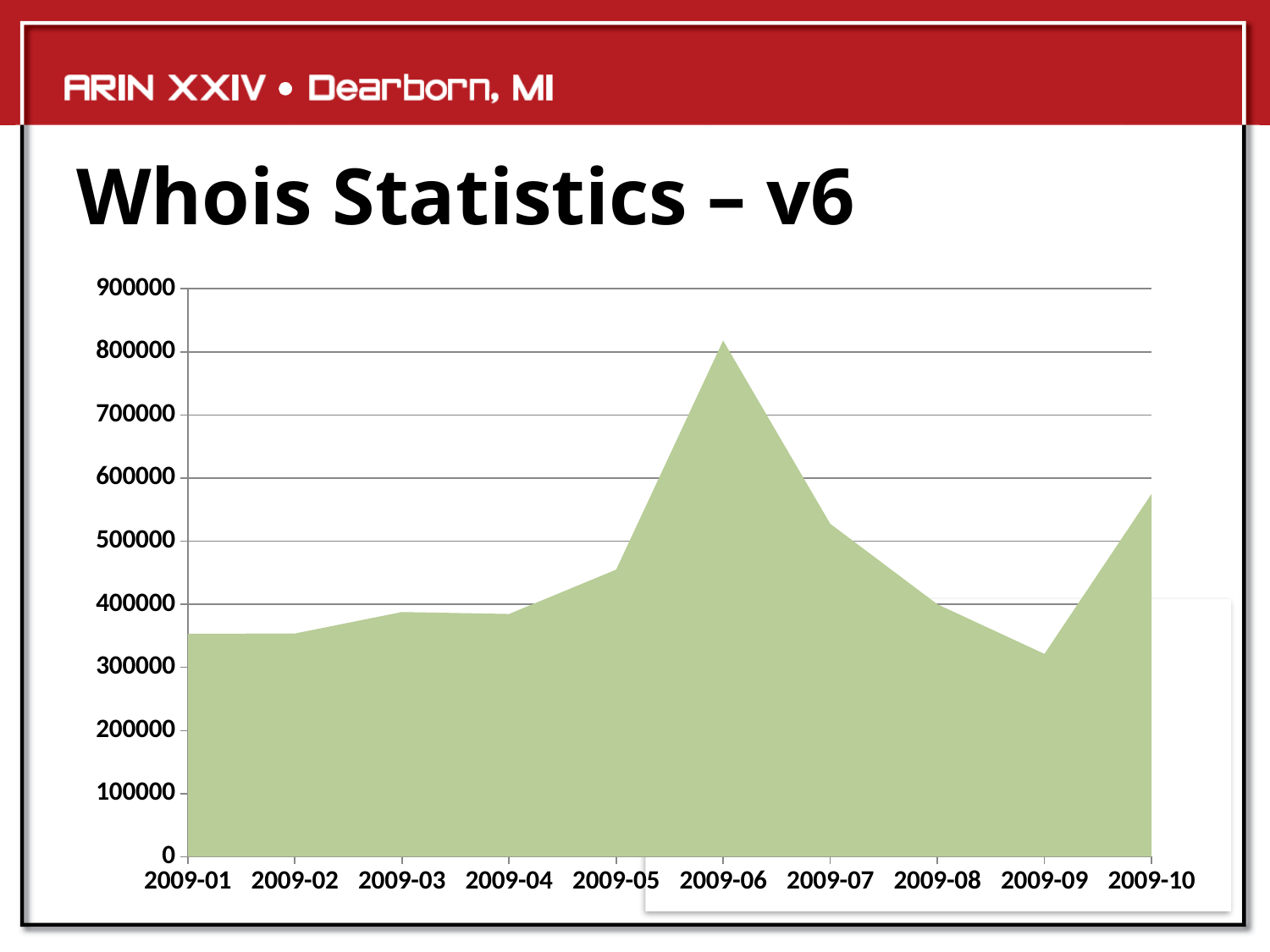
Which month has the lowest value in the chart? 2009-09 Is the value for 2009-09 greater or less than 400000? less Is the value for 2009-06 greater or less than 700000? greater Is the value for 2009-01 greater or less than 400000? less Do the values rise or fall from 2009-06 to 2009-09? fall Which month has the highest value in the chart? 2009-06 What kind of chart is shown on the slide? Area chart Which is larger, the value for 2009-07 or the value for 2009-08? 2009-07 Which is larger, the value for 2009-06 or the value for 2009-10? 2009-06 What is the title of the slide containing the chart? Whois Statistics – v6 How many months are plotted along the x axis of the chart? 10